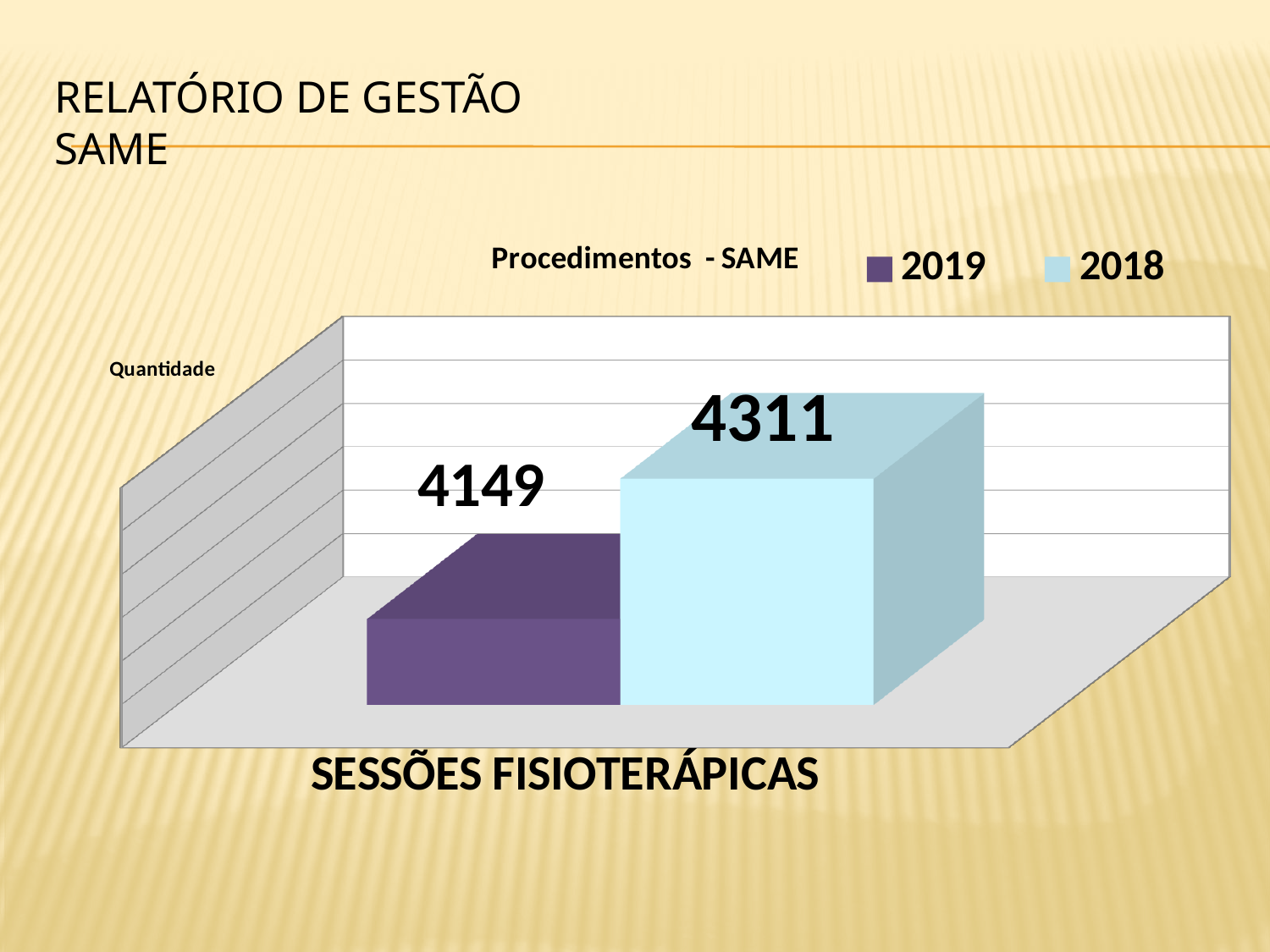
What is the value for 2018 in the Procedimentos - SAME chart? 4311 Which series has the lowest value in the chart? 2019 What kind of chart is shown on the slide? Bar chart How many series does the legend list? 2 What is the difference between the 2018 and 2019 values? 162 How many categories are shown on the x axis? 1 What is the total of the 2019 and 2018 values? 8460 Which series has the higher value, 2019 or 2018? 2018 What is the category label on the x axis? SESSÕES FISIOTERÁPICAS What is the value for 2019 in the Procedimentos - SAME chart? 4149 What is the title of the chart? Procedimentos - SAME